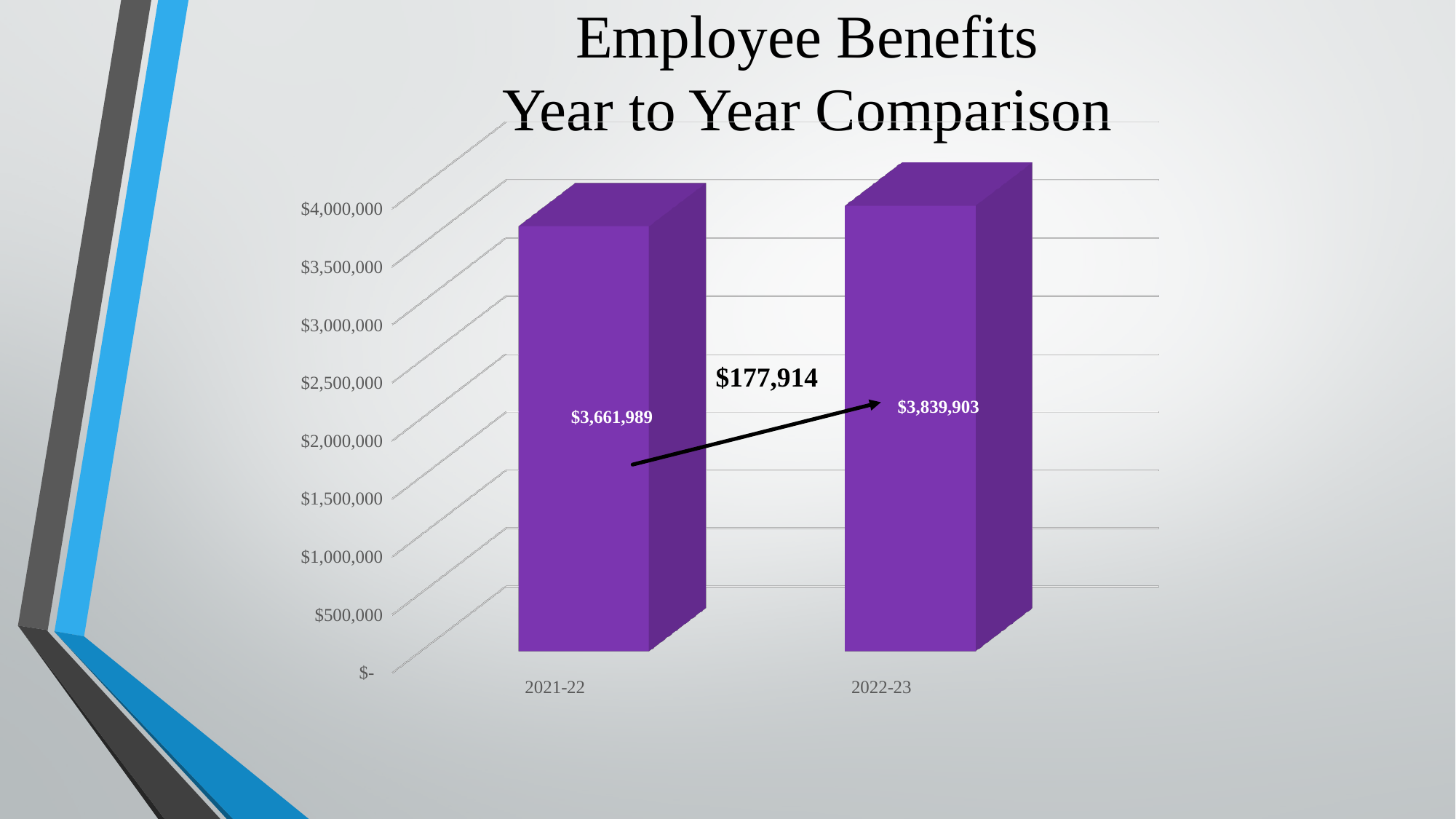
Do the values rise or fall from 2021-22 to 2022-23? rise What is the title of the chart? Employee Benefits Year to Year Comparison How many categories are shown on the x axis? 2 What is the value for 2021-22? $3,661,989 What is the difference between the 2022-23 and 2021-22 values? $177,914 Which year has the lower employee benefits value? 2021-22 Is the value for 2021-22 larger or smaller than the value for 2022-23? smaller What kind of chart is shown on the slide? bar chart Is the value for 2022-23 greater or less than $4,000,000? less Which year has the higher employee benefits value? 2022-23 Is the value for 2021-22 greater or less than $3,500,000? greater What is the value for 2022-23? $3,839,903